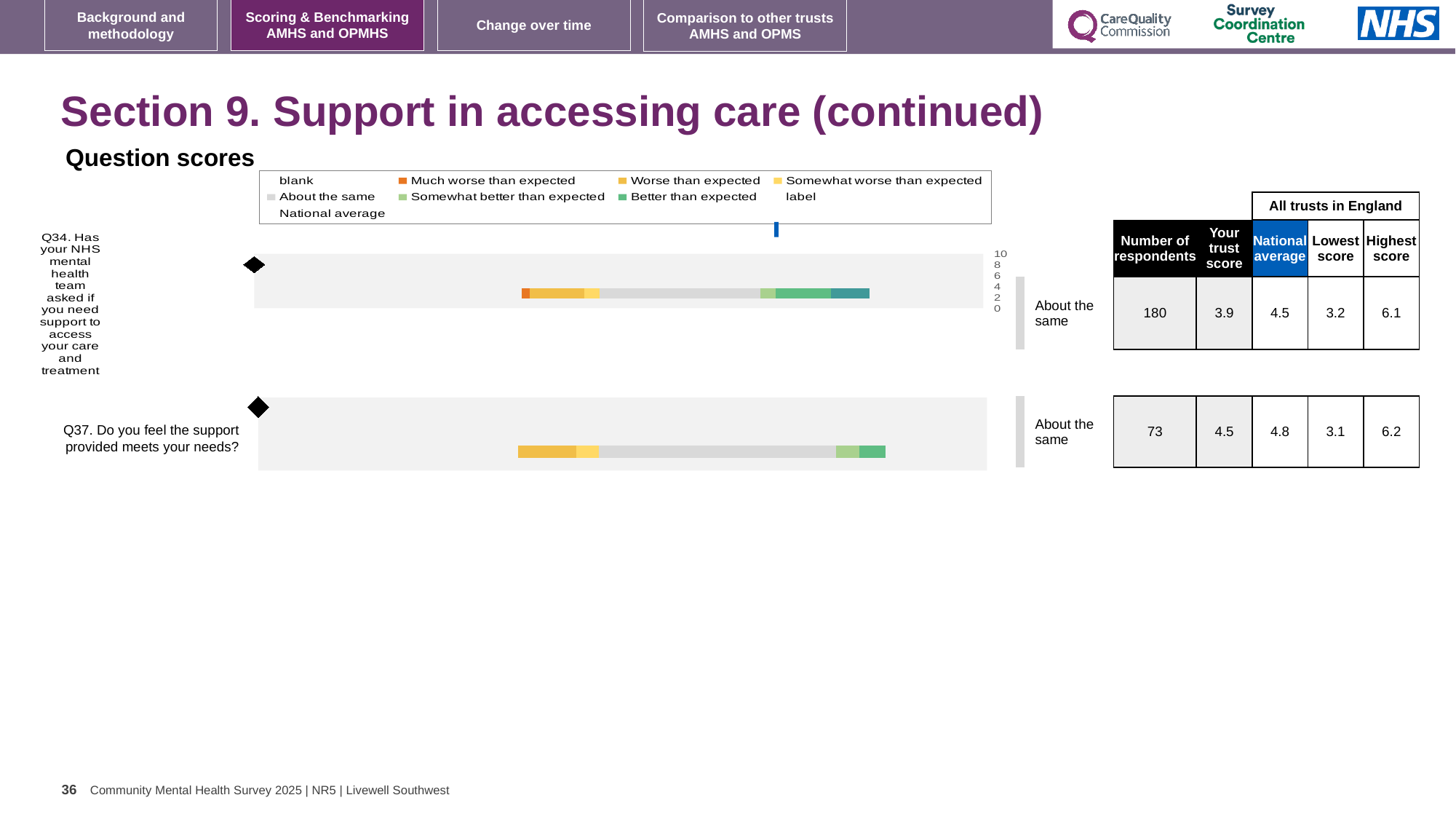
What is the difference between the national average and the trust score for Q37? 0.3 What is the difference between the highest score and the lowest score for Q34? 2.9 What colour does the legend use for 'Much worse than expected'? orange What is the trust score for Q34 (Has your NHS mental health team asked if you need support to access your care and treatment)? 3.9 How many entries does the legend of the question scores chart list? 9 How many respondents answered Q34? 180 What kind of chart is used to show the question scores for Q34 and Q37? bar chart For Q37, which is larger: the trust score or the national average? national average What benchmark category is shown next to the bar for Q34? About the same What is the national average for Q37 (Do you feel the support provided meets your needs)? 4.8 How many questions (bars) are plotted in the question scores chart? 2 Which question has more respondents, Q34 or Q37? Q34